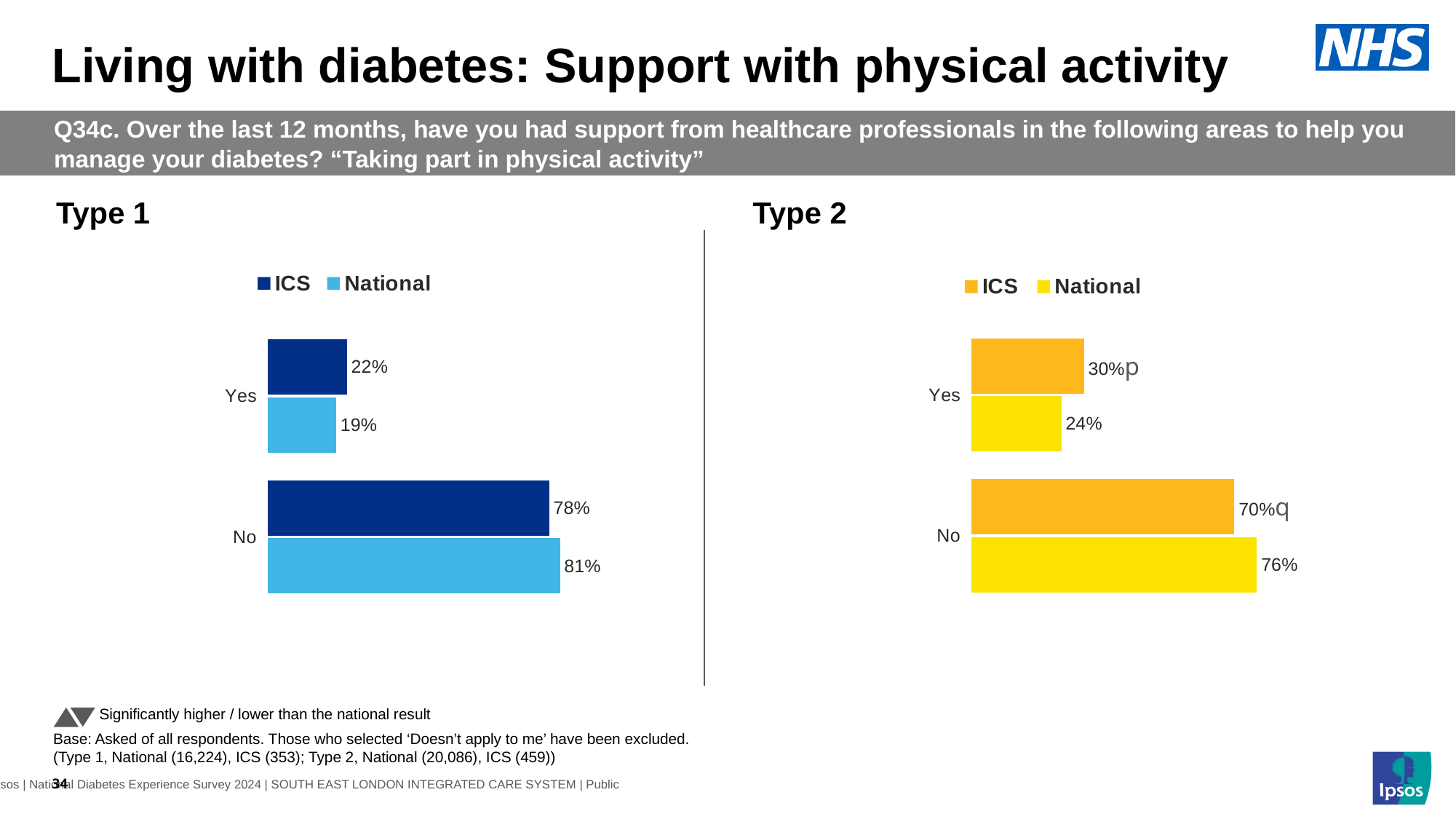
How many series does the legend of the Type 2 chart list? 2 In the Type 1 chart, what is the ICS value for Yes? 22% In the Type 2 chart, what is the National value for No? 76% In the Type 2 chart, what is the difference between the ICS and National values for Yes? 6% In the Type 2 chart, what colour represents the National series? Yellow What kind of chart is the Type 1 chart? Bar chart In the Type 1 chart, what is the National value for No? 81% In the Type 2 chart, which is larger for No: ICS or National? National How many categories are shown in the Type 1 chart? 2 In the Type 1 chart, which is larger for Yes: ICS or National? ICS In the Type 2 chart, what is the ICS value for Yes? 30% In the Type 1 chart, what is the difference between the ICS and National values for No? 3%